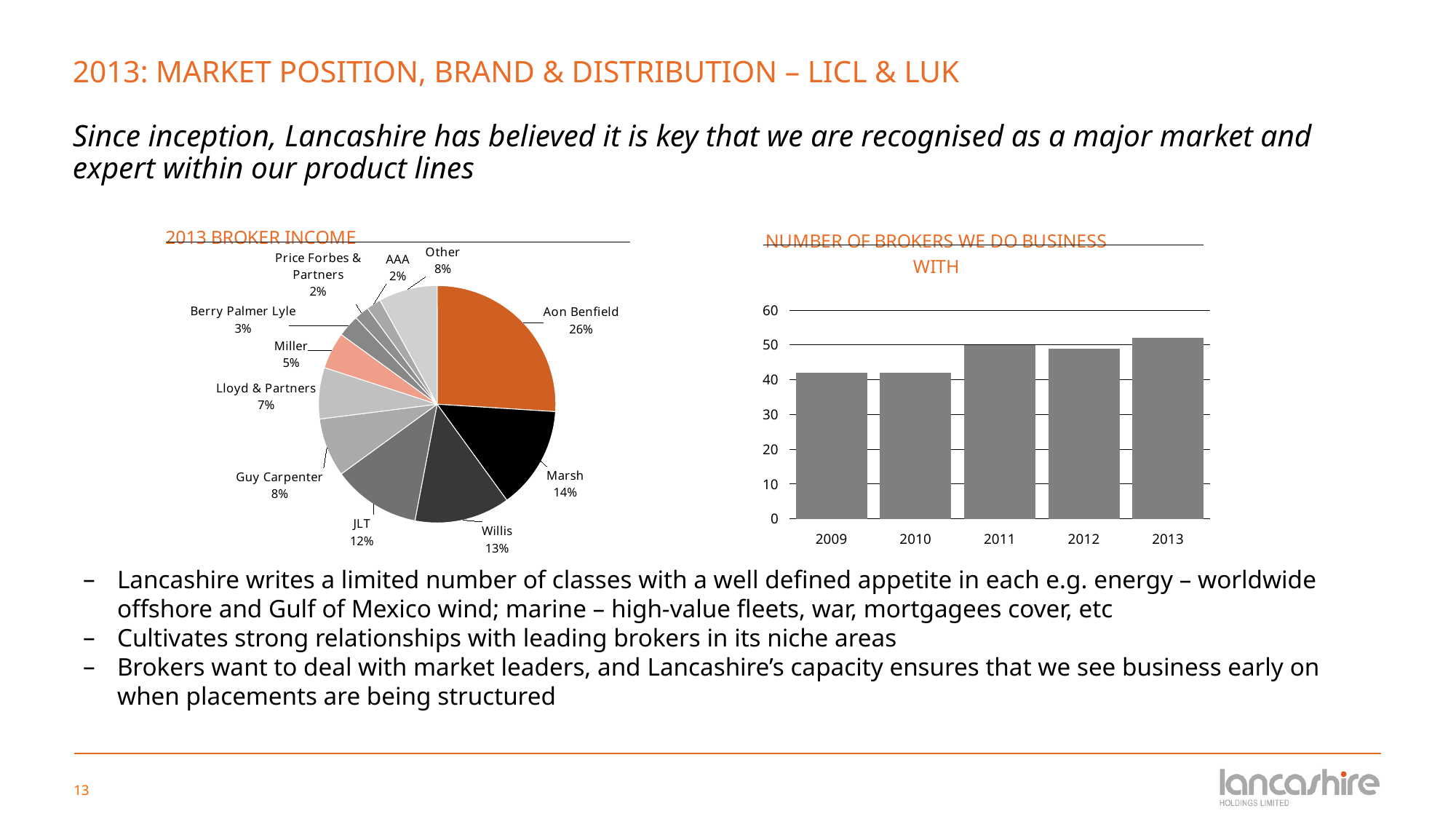
In the Number of Brokers We Do Business With chart, is the value for 2009 greater or less than 40? greater In the 2013 Broker Income pie chart, which has the larger share, Guy Carpenter or Lloyd & Partners? Guy Carpenter In the Number of Brokers We Do Business With chart, is the value for 2013 greater or less than 50? greater What kind of chart is the 2013 Broker Income chart? Pie chart In the Number of Brokers We Do Business With chart, which year has the highest value? 2013 In the 2013 Broker Income pie chart, which broker has the largest share? Aon Benfield In the 2013 Broker Income pie chart, what percentage is attributed to Willis? 13% How many years are shown in the Number of Brokers We Do Business With chart? 5 In the 2013 Broker Income pie chart, what is the difference in percentage points between Marsh and JLT? 2 What kind of chart is the Number of Brokers We Do Business With chart? Bar chart In the 2013 Broker Income pie chart, what share of broker income comes from Aon Benfield? 26% How many slices does the 2013 Broker Income pie chart have? 11